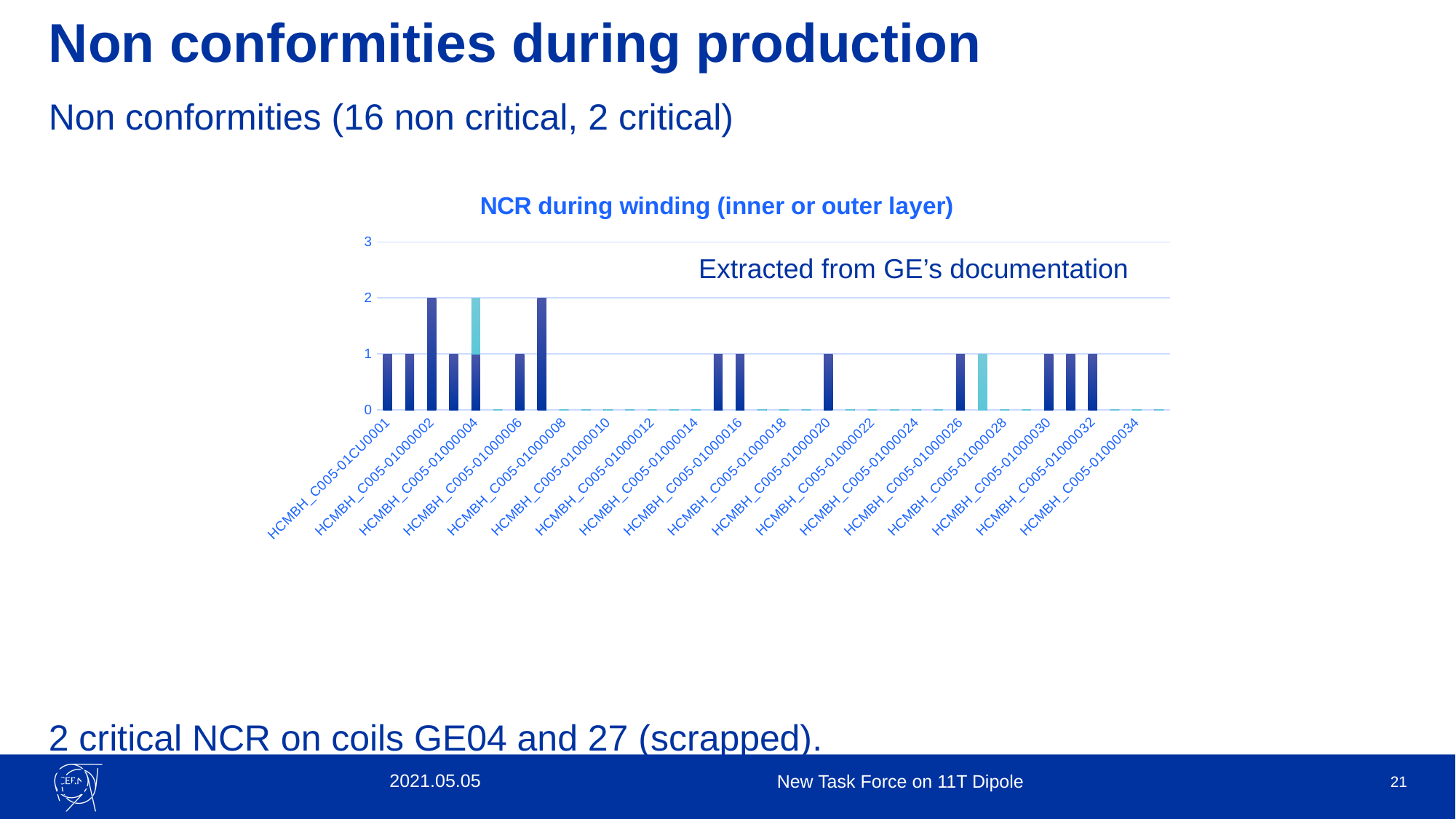
Which is larger, the value for HCMBH_C005-01000002 or HCMBH_C005-01000006? HCMBH_C005-01000002 What is the value for HCMBH_C005-01000034? 0 What is the value for HCMBH_C005-01000020? 1 What is the value for HCMBH_C005-01000006? 1 What is the value for HCMBH_C005-01000008? 0 Is the value for HCMBH_C005-01000004 greater or less than 1? greater How many category labels are shown on the x axis? 18 What is the highest value shown on the y axis? 3 What is the value for HCMBH_C005-01000002? 2 What is the difference between the values for HCMBH_C005-01000002 and HCMBH_C005-01000030? 1 What is the title of the chart? NCR during winding (inner or outer layer) What type of chart is shown on the slide? bar chart